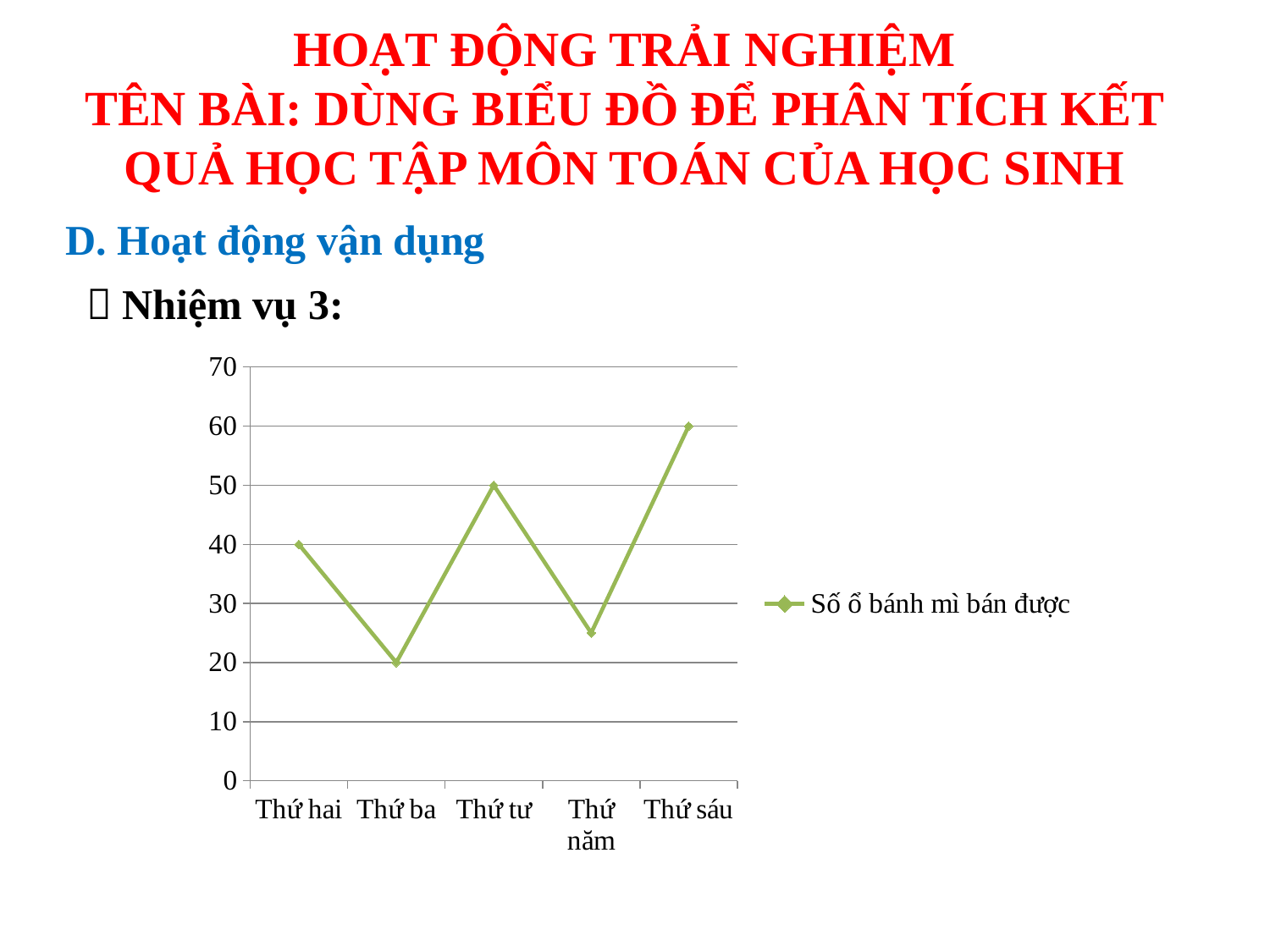
What is the value for Thứ ba? 20 Which day has the highest value? Thứ sáu Is the value for Thứ năm greater or less than 30? less How many days are plotted on the x axis of the chart? 5 What is the value for Thứ sáu? 60 What is the name of the series shown in the legend? Số ổ bánh mì bán được What is the value for Thứ tư? 50 What is the value for Thứ hai? 40 What kind of chart is shown on the slide? line chart What is the difference between the values for Thứ sáu and Thứ ba? 40 Which day has the lowest value? Thứ ba How many series does the chart's legend list? 1